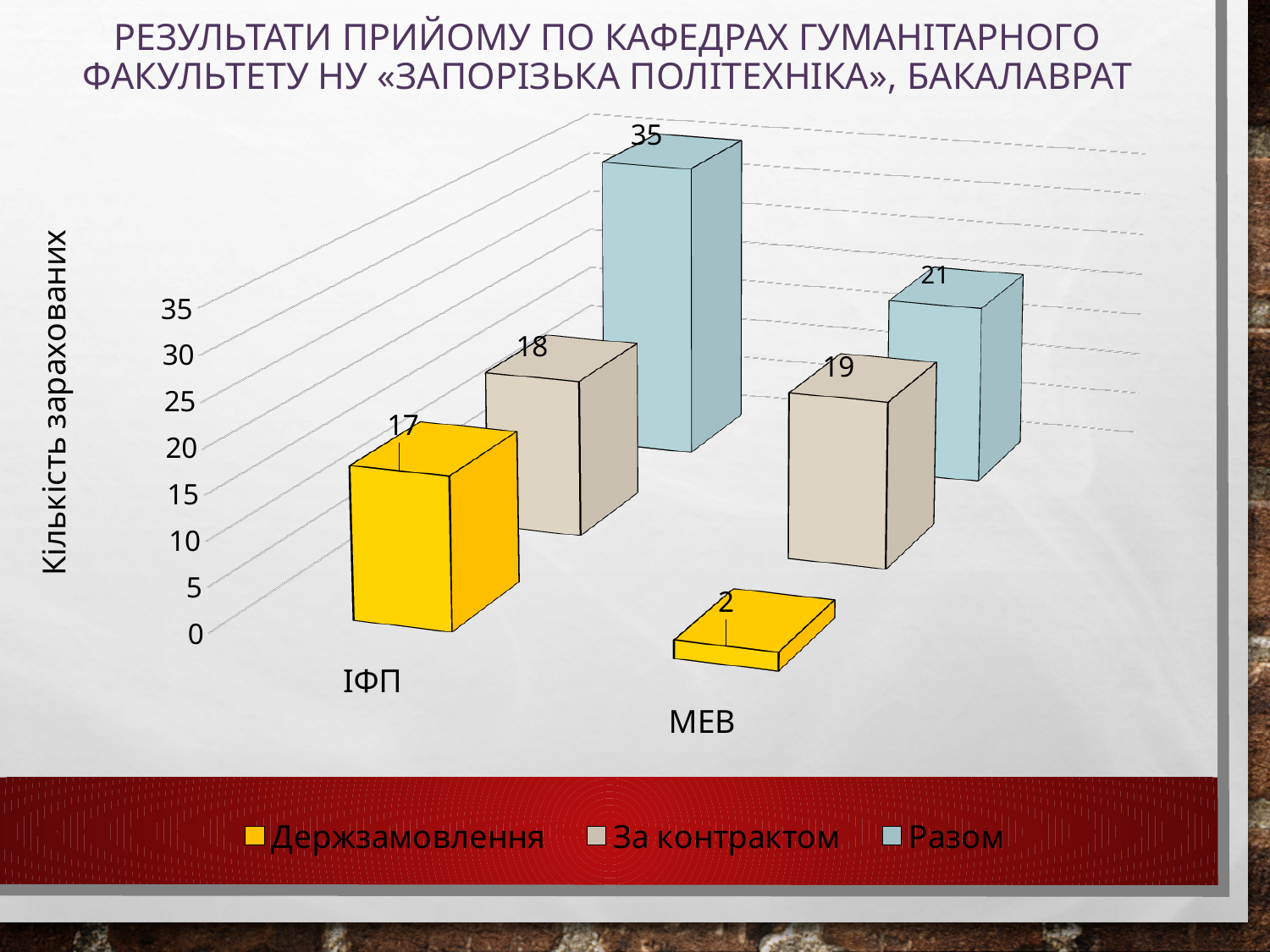
What is the value of Держзамовлення for МЕВ? 2 What is the difference between the Разом values for ІФП and МЕВ? 14 How many series does the legend list? 3 What is the value of Разом for ІФП? 35 What is the value of Разом for МЕВ? 21 What is the value of Держзамовлення for ІФП? 17 What kind of chart is shown on the slide? Bar chart What is the value of За контрактом for МЕВ? 19 How many categories are shown on the x axis? 2 Which is larger: Держзамовлення for ІФП or Держзамовлення for МЕВ? Держзамовлення for ІФП Which category has the lowest Держзамовлення value? МЕВ Which category has the highest Разом value? ІФП